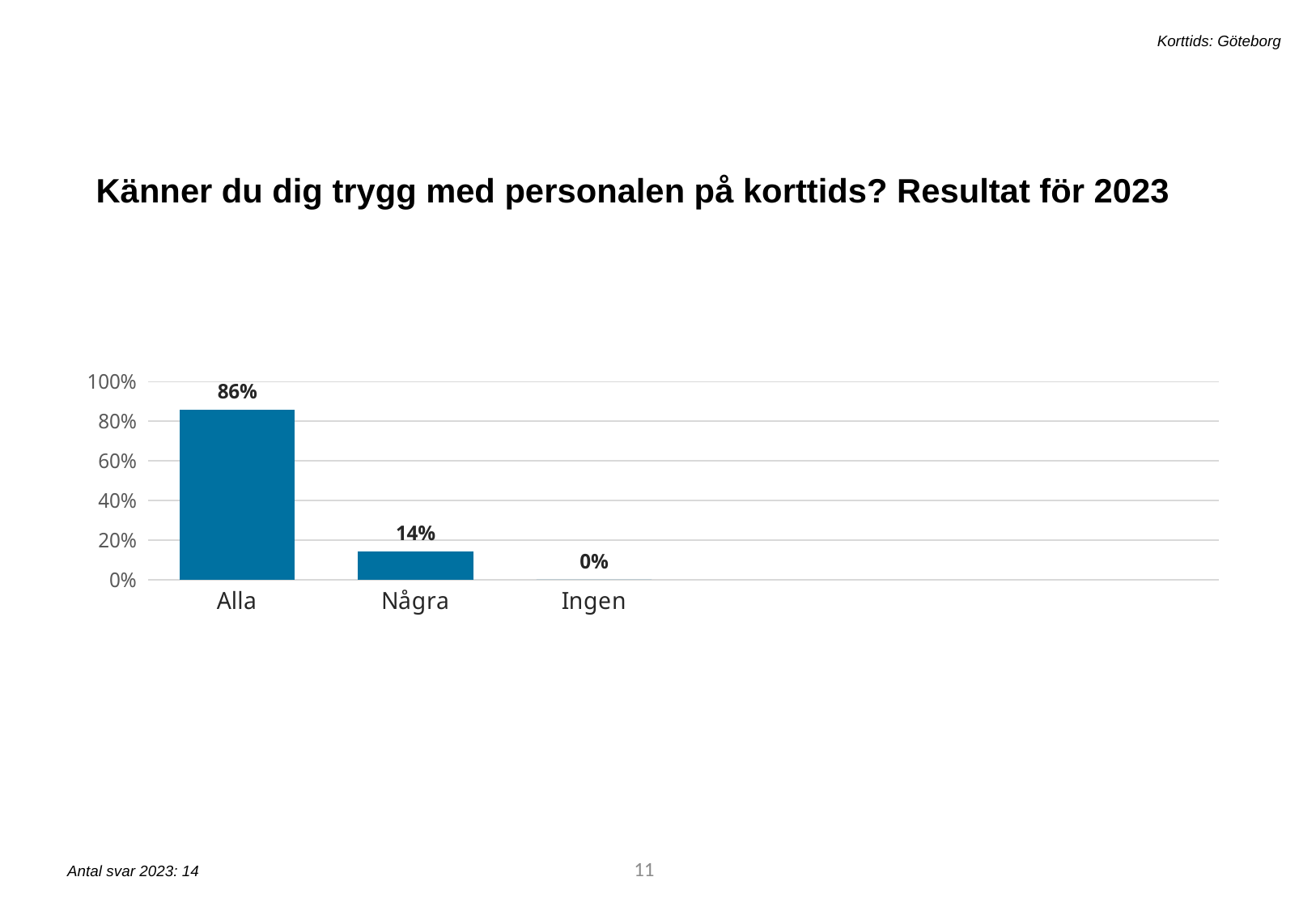
Which is larger, the value for Några or the value for Ingen? Några What is the value for Några? 14% What kind of chart is shown on the slide? bar chart Which category has the lowest value? Ingen What is the difference between the values for Alla and Några? 72% Is the value for Några greater or less than 20%? less How many categories are shown on the x axis? 3 What is the value for Alla? 86% Is the value for Alla greater or less than 80%? greater What is the title of the chart? Känner du dig trygg med personalen på korttids? Resultat för 2023 What is the value for Ingen? 0% Which category has the highest value? Alla